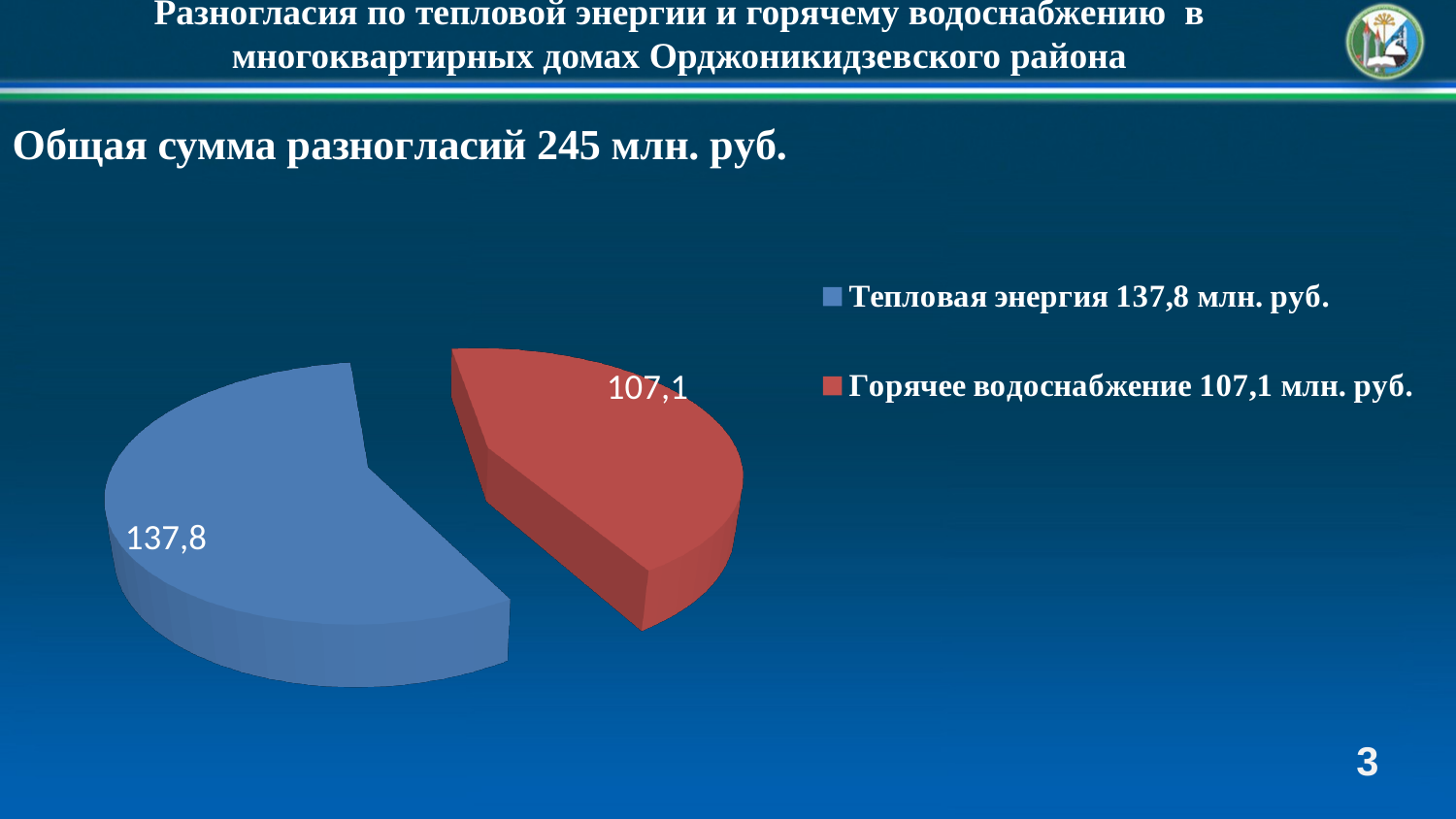
How many entries does the legend list? 2 Which category has the largest slice of the pie? Тепловая энергия What is the value of the Горячее водоснабжение slice? 107,1 What colour is the Горячее водоснабжение slice? Red What type of chart is shown on the slide? Pie chart Which category has the smallest slice of the pie? Горячее водоснабжение How many slices does the pie chart have? 2 What is the difference between the Тепловая энергия and Горячее водоснабжение values? 30,7 What is the value of the Тепловая энергия slice? 137,8 What total sum of disagreements is stated above the chart? 245 млн. руб. Which is larger: Тепловая энергия or Горячее водоснабжение? Тепловая энергия